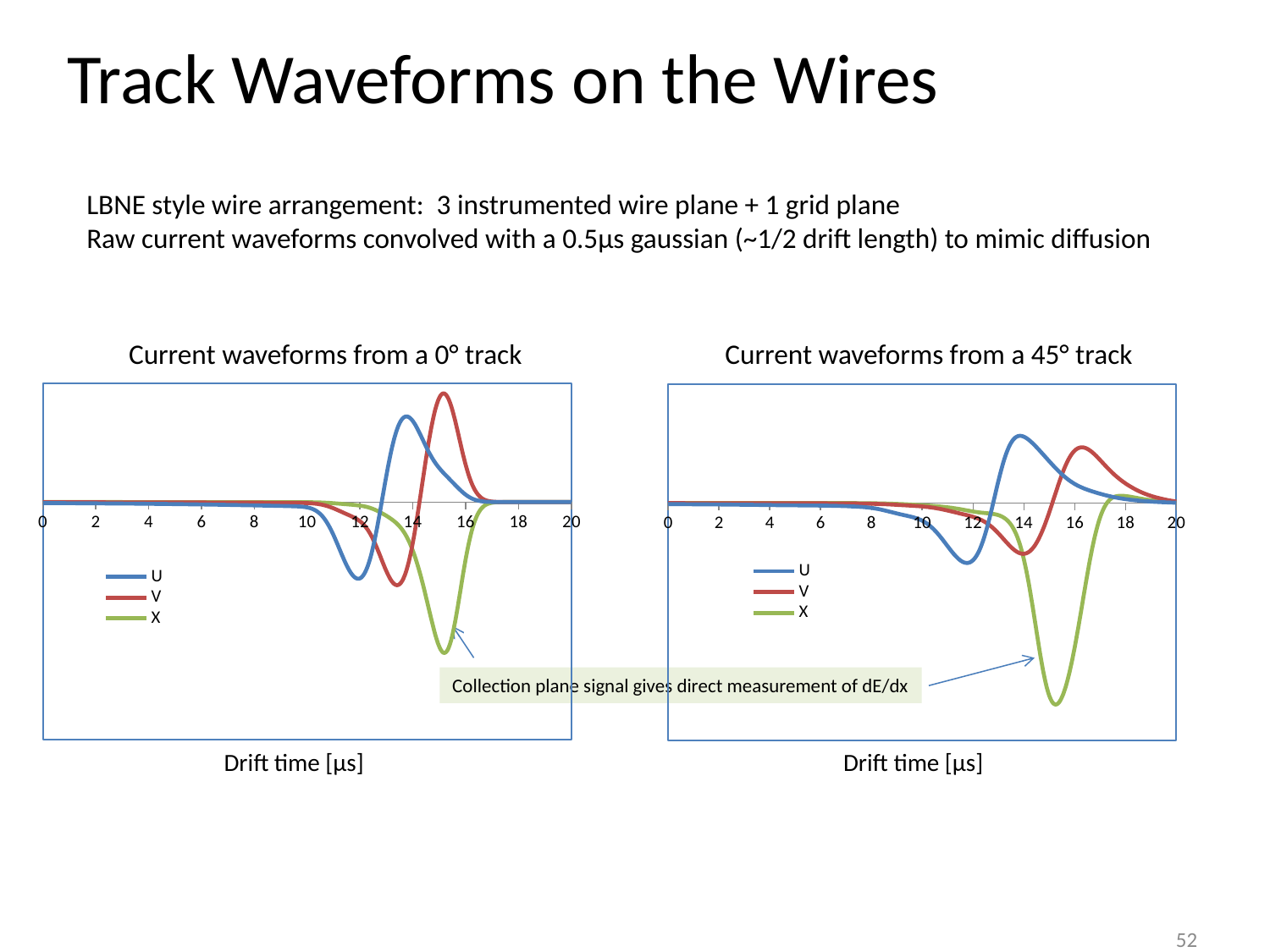
In "Current waveforms from a 0° track", which series reaches the highest positive peak? V In "Current waveforms from a 45° track", is the negative dip of X deeper than the negative dip of U? yes In "Current waveforms from a 0° track", which series reaches the lowest (most negative) value? X In "Current waveforms from a 45° track", which series reaches the highest positive peak? U How many series does the legend of "Current waveforms from a 45° track" list? 3 What is the x-axis label of the chart "Current waveforms from a 45° track"? Drift time [μs] In "Current waveforms from a 0° track", is the positive peak of V larger or smaller than the positive peak of U? larger What are the series names in the legend of "Current waveforms from a 0° track"? U, V, X What kind of chart is "Current waveforms from a 0° track"? line chart What is the maximum value shown on the x axis of "Current waveforms from a 0° track"? 20 In "Current waveforms from a 0° track", does the X series rise or fall between drift time 14 and 15? fall In "Current waveforms from a 45° track", which series reaches the lowest (most negative) value? X